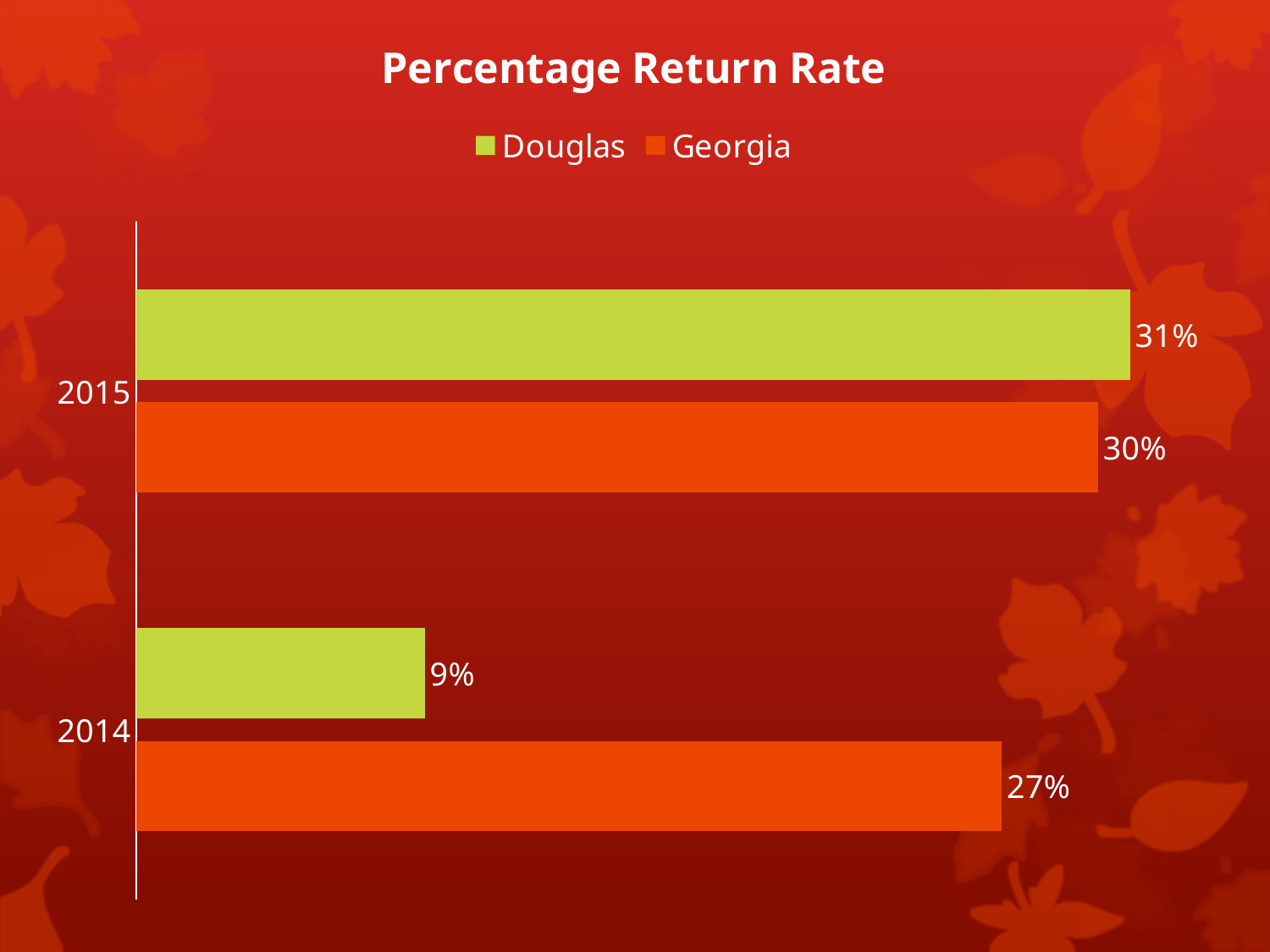
What is the difference between the Douglas values for 2015 and 2014? 22% Which year has the lowest Douglas value? 2014 Which is larger in 2014, the Douglas value or the Georgia value? Georgia What is the Georgia value for 2015? 30% How many years are shown on the chart? 2 What is the Georgia value for 2014? 27% What kind of chart is shown? Bar chart How many series does the legend list? 2 Which year has the highest Georgia value? 2015 What is the Douglas value for 2014? 9% What is the Douglas value for 2015? 31% What is the difference between the Georgia and Douglas values for 2014? 18%